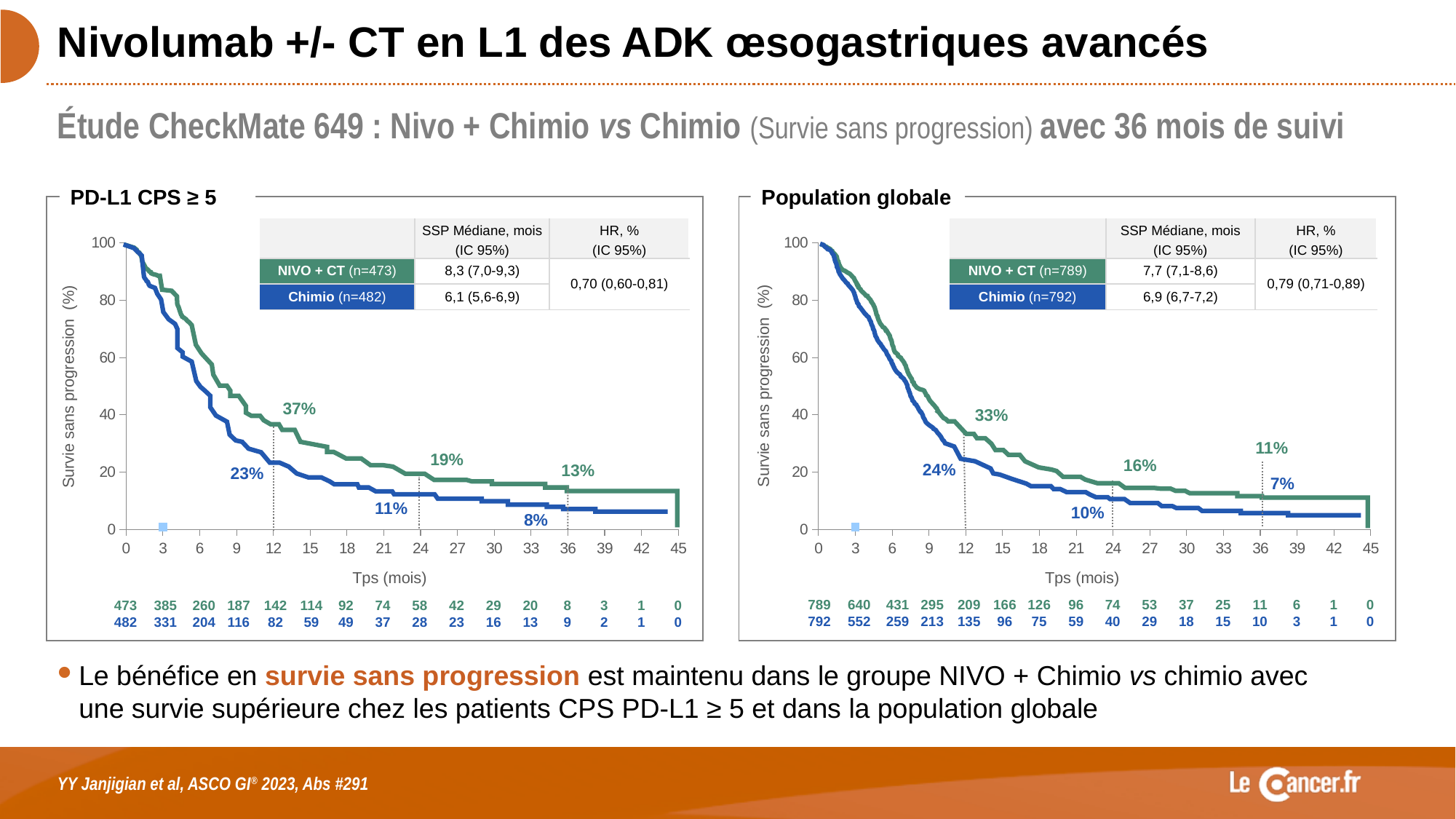
What kind of chart is used in the PD-L1 CPS ≥ 5 panel? Line chart (Kaplan-Meier survival curve) In the Population globale chart, what is the progression-free survival rate for NIVO + CT at 24 months? 16% In the Population globale chart, which group has the higher progression-free survival rate at 12 months, NIVO + CT or Chimio? NIVO + CT In the PD-L1 CPS ≥ 5 chart, what is the difference between the NIVO + CT and Chimio rates at 24 months? 8% In the Population globale chart, do the curves rise or fall as time (Tps, mois) increases? Fall In the PD-L1 CPS ≥ 5 chart, what is the progression-free survival rate for NIVO + CT at 12 months? 37% How many series are plotted in the Population globale chart? 2 In the PD-L1 CPS ≥ 5 chart, what is the median SSP in months for NIVO + CT? 8,3 (7,0-9,3) In the Population globale chart, what is the difference between the NIVO + CT and Chimio rates at 36 months? 4% In the PD-L1 CPS ≥ 5 chart, is the NIVO + CT curve at 6 months greater or less than 40? greater In the PD-L1 CPS ≥ 5 chart, what is the progression-free survival rate for Chimio at 36 months? 8% In the Population globale chart, what is the progression-free survival rate for Chimio at 12 months? 24%